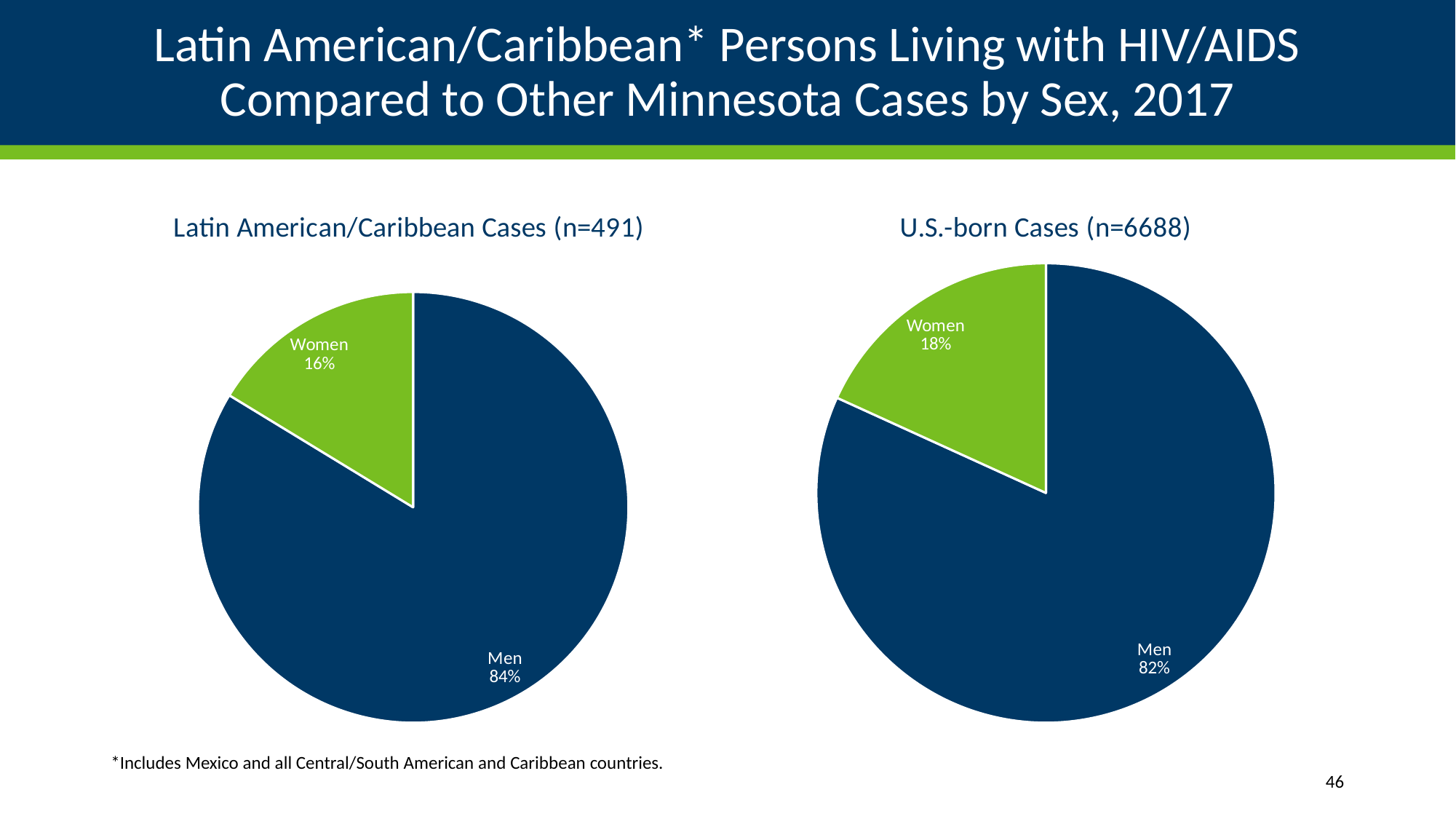
In the Latin American/Caribbean Cases pie chart, what percentage of cases are Men? 84% In the U.S.-born Cases pie chart, what percentage of cases are Men? 82% In the Latin American/Caribbean Cases pie chart, what is the difference in percentage points between Men and Women? 68 How many slices does the U.S.-born Cases pie chart have? 2 In the Latin American/Caribbean Cases pie chart, what percentage of cases are Women? 16% What colour is the Women slice in the Latin American/Caribbean Cases pie chart? Green What is the sample size (n) shown in the title of the U.S.-born Cases chart? 6688 Which chart shows a larger share for Women, the Latin American/Caribbean Cases chart or the U.S.-born Cases chart? U.S.-born Cases In the Latin American/Caribbean Cases pie chart, which slice is the largest? Men What type of chart is used for the Latin American/Caribbean Cases? Pie chart In the U.S.-born Cases pie chart, which slice is the smallest? Women In the U.S.-born Cases pie chart, what percentage of cases are Women? 18%